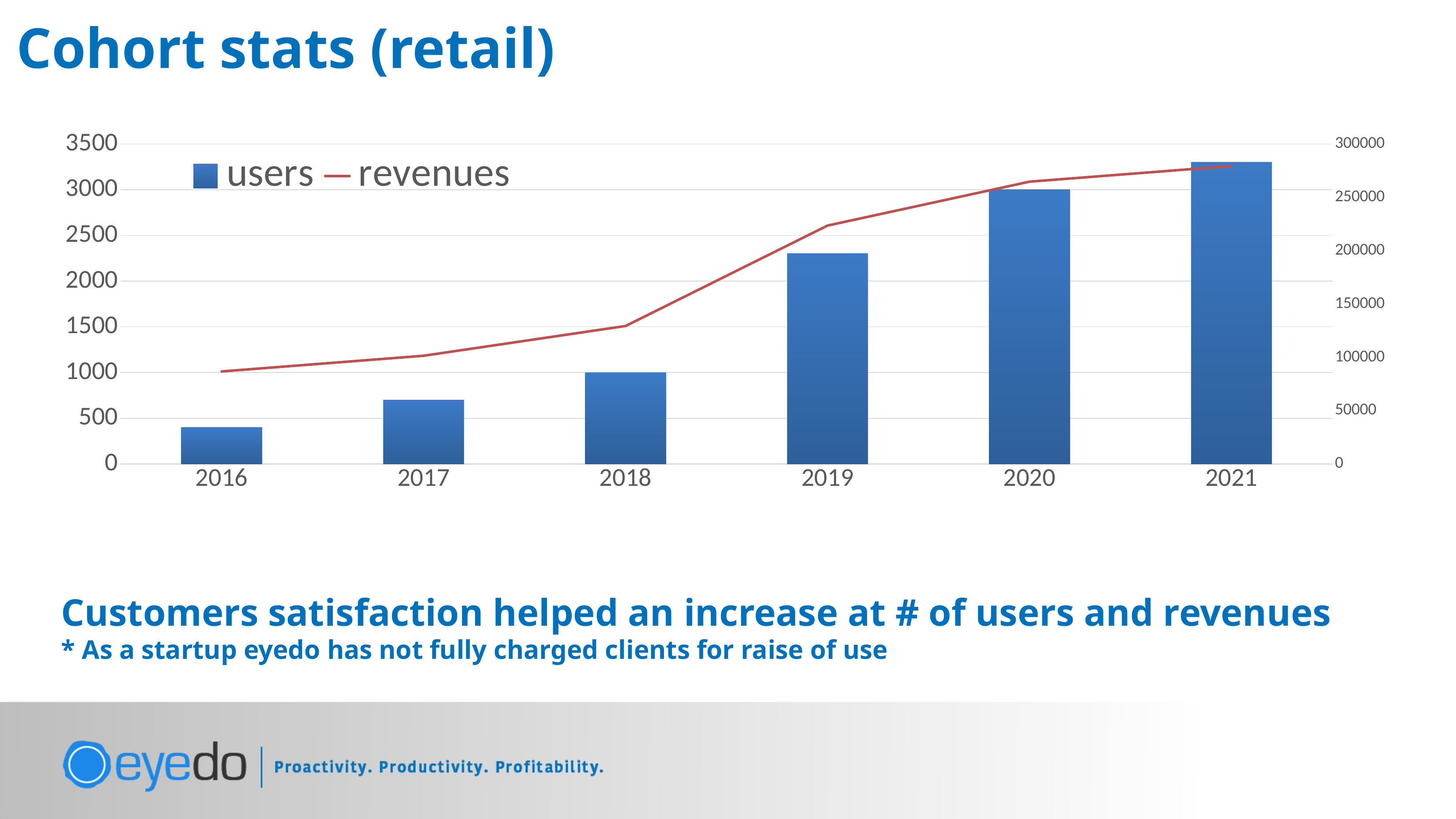
Is the value for users in 2016 greater or less than 500? less Which year has the highest number of users? 2021 What is the value for users in 2020? 3000 Is the value for revenues in 2019 greater or less than 200000? greater Which series is drawn as a red line in the chart? revenues How many years are shown on the x axis of the chart? 6 How many series does the chart legend list? 2 Is the value for users in 2019 greater or less than 2000? greater Which year has more users, 2018 or 2019? 2019 What is the value for users in 2018? 1000 Do revenues rise or fall from 2016 to 2021? rise Which year has the lowest number of users? 2016